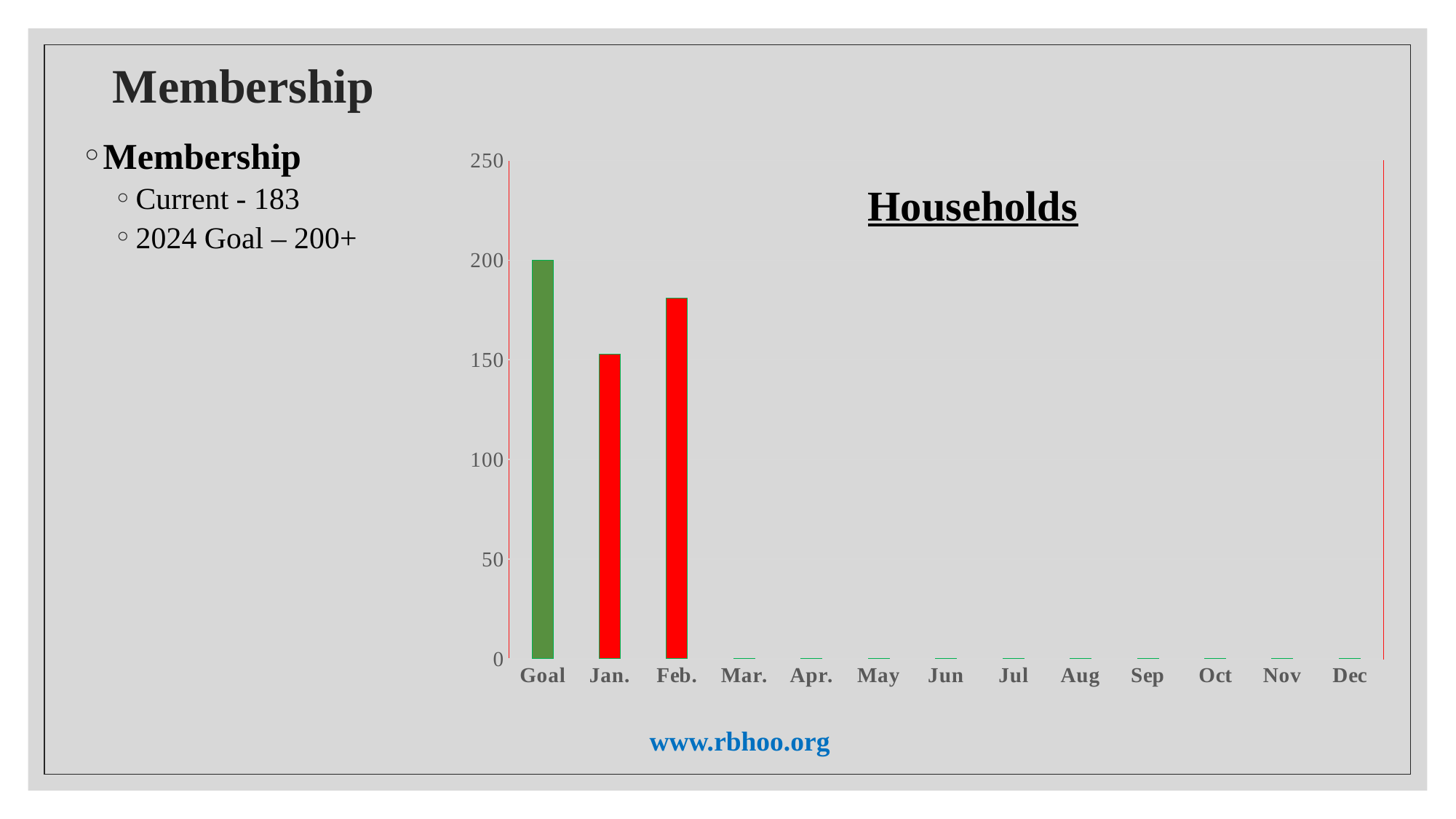
What is the value of the Goal bar in the chart? 200 Which category has the highest bar in the chart? Goal Is the value for Feb. greater or less than 200? less What is the title of the chart? Households What kind of chart is shown on the slide? bar chart How many categories are shown on the x axis of the chart? 13 Which is larger, the bar for Jan. or the bar for Feb.? Feb. Is the value for Feb. greater or less than 150? greater Do the values rise or fall from Jan. to Feb.? rise Is the value for Jan. greater or less than 200? less Which is larger, the bar for Goal or the bar for Feb.? Goal What colour is the Goal bar in the chart? green